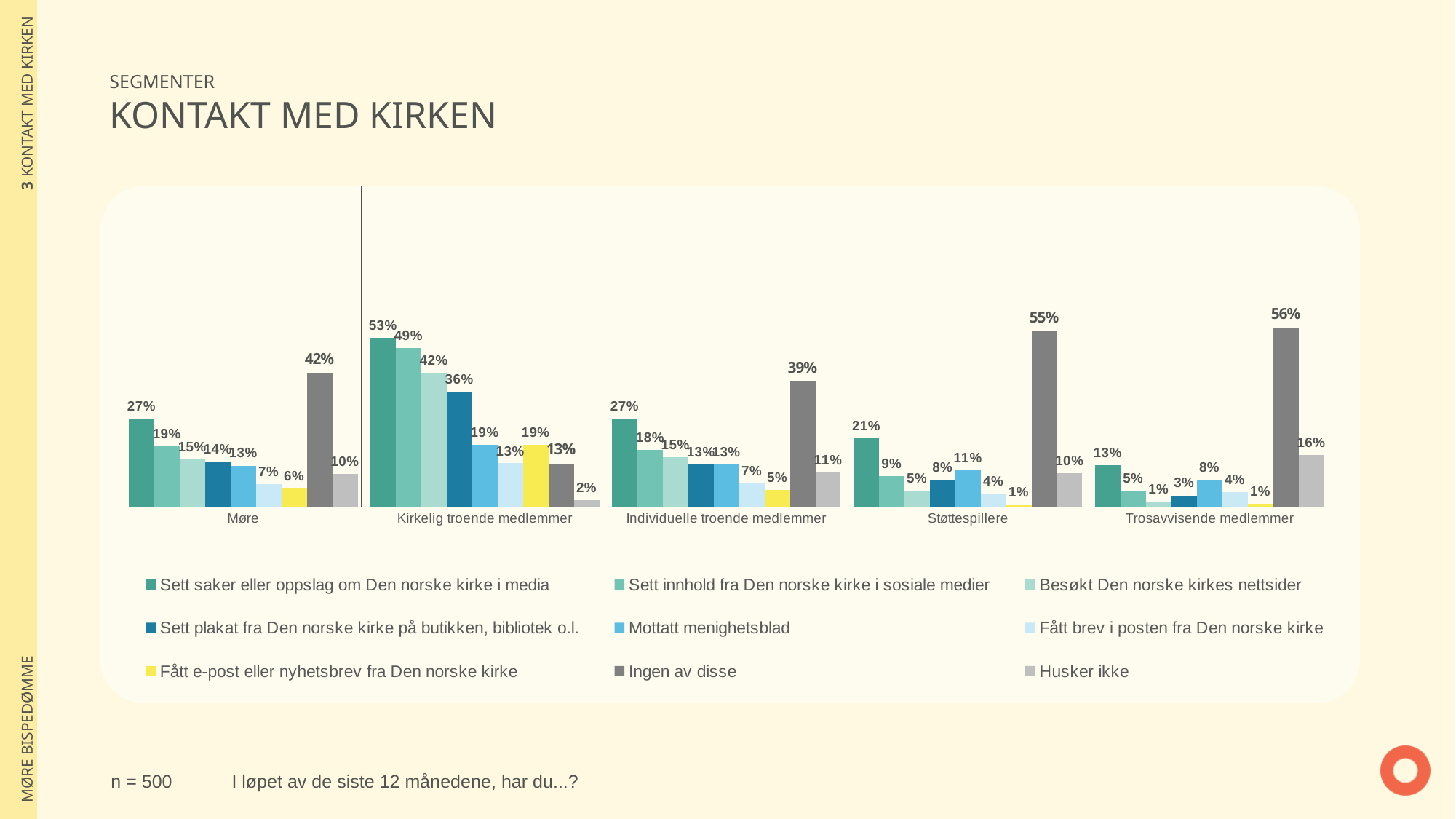
Which group has the highest value for "Ingen av disse"? Trosavvisende medlemmer What is the difference between "Ingen av disse" for Støttespillere and for Individuelle troende medlemmer? 16% How many groups (categories) are shown on the x axis? 5 What is the value for "Ingen av disse" in the Møre group? 42% What is the value for "Husker ikke" in the Trosavvisende medlemmer group? 16% What kind of chart is shown on the slide? Bar chart What colour is the bar for "Fått e-post eller nyhetsbrev fra Den norske kirke"? Yellow What is the value for "Mottatt menighetsblad" in the Støttespillere group? 11% Which is larger: "Besøkt Den norske kirkes nettsider" for Kirkelig troende medlemmer or for Møre? Kirkelig troende medlemmer Which group has the lowest value for "Husker ikke"? Kirkelig troende medlemmer How many series does the legend list? 9 What is the value for "Sett saker eller oppslag om Den norske kirke i media" in the Kirkelig troende medlemmer group? 53%